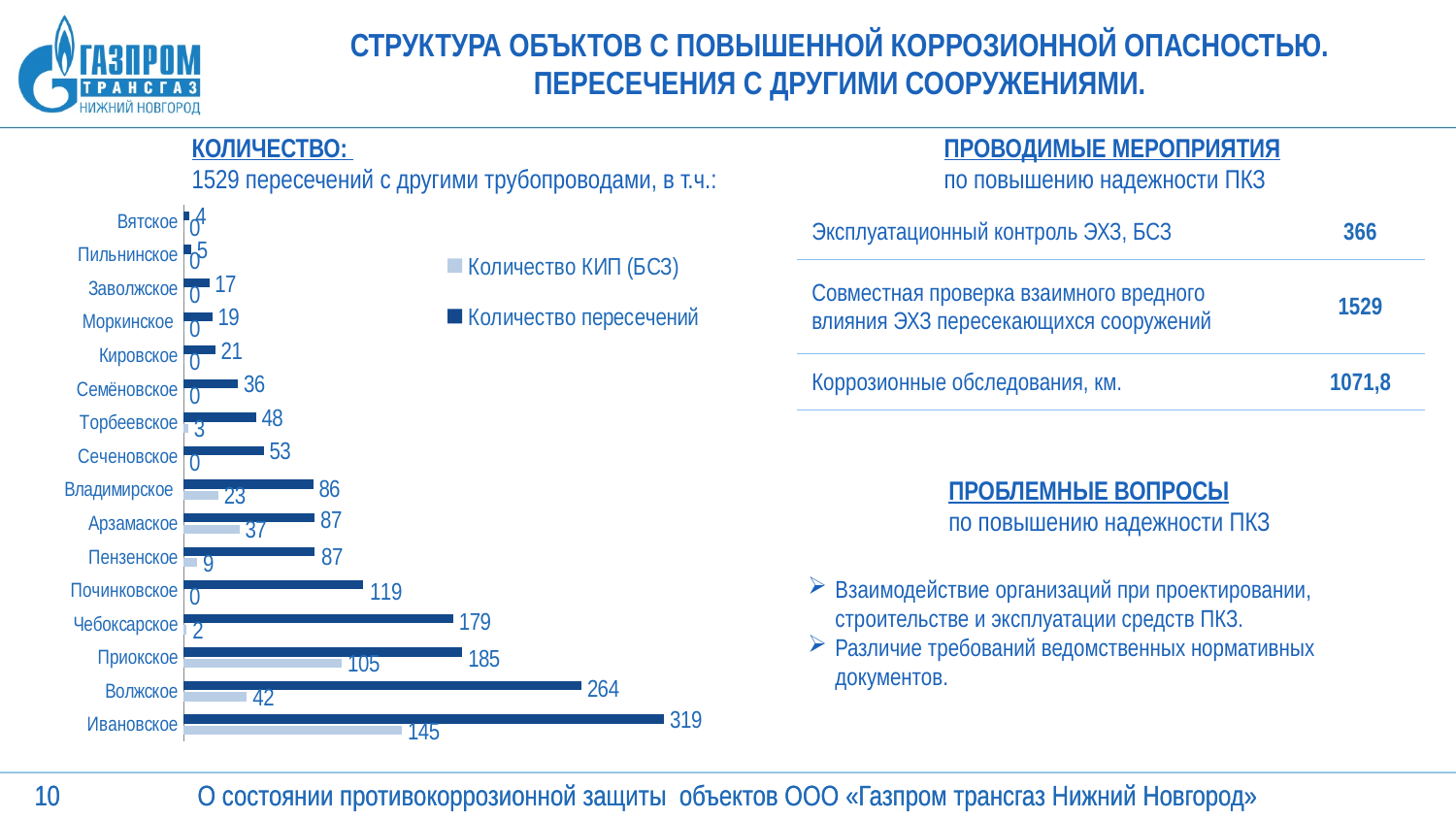
Which category has the lowest value of Количество пересечений? Вятское How many series does the chart legend list? 2 What kind of chart is shown on the slide? bar chart What is the value of Количество пересечений for Ивановское? 319 Which is larger: Количество КИП (БСЗ) for Арзамаское or for Владимирское? Арзамаское Which category has the highest value of Количество пересечений? Ивановское What is the value of Количество пересечений for Семёновское? 36 Which series is shown in dark blue in the legend? Количество пересечений How many categories (regions) are shown on the chart? 16 What is the value of Количество КИП (БСЗ) for Приокское? 105 What is the value of Количество КИП (БСЗ) for Торбеевское? 3 What is the difference between Количество пересечений for Волжское and Чебоксарское? 85